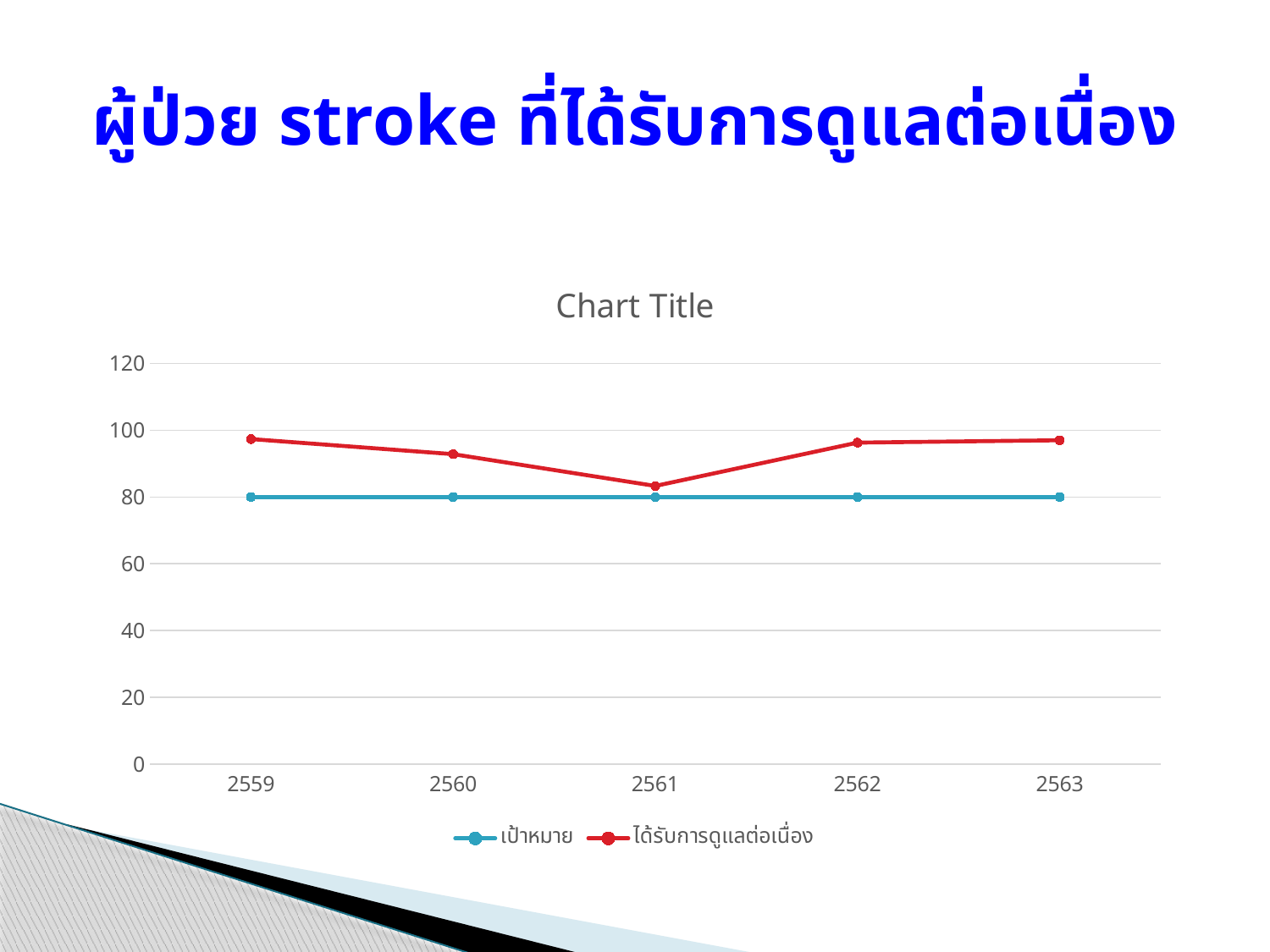
In which year is the ได้รับการดูแลต่อเนื่อง series at its lowest? 2561 Which is larger, the ได้รับการดูแลต่อเนื่อง value in 2560 or in 2561? 2560 What is the title printed above the chart? Chart Title Is the value of ได้รับการดูแลต่อเนื่อง in 2560 greater or less than 80? greater How many series does the chart legend list? 2 What kind of chart is shown on the slide? line chart Is the value of ได้รับการดูแลต่อเนื่อง in 2559 greater or less than 100? less What is the value of the เป้าหมาย series in 2563? 80 Does the ได้รับการดูแลต่อเนื่อง series rise or fall from 2559 to 2561? fall What is the value of the เป้าหมาย series in 2561? 80 How many years are shown on the x axis of the chart? 5 Which series is drawn in red in the chart? ได้รับการดูแลต่อเนื่อง